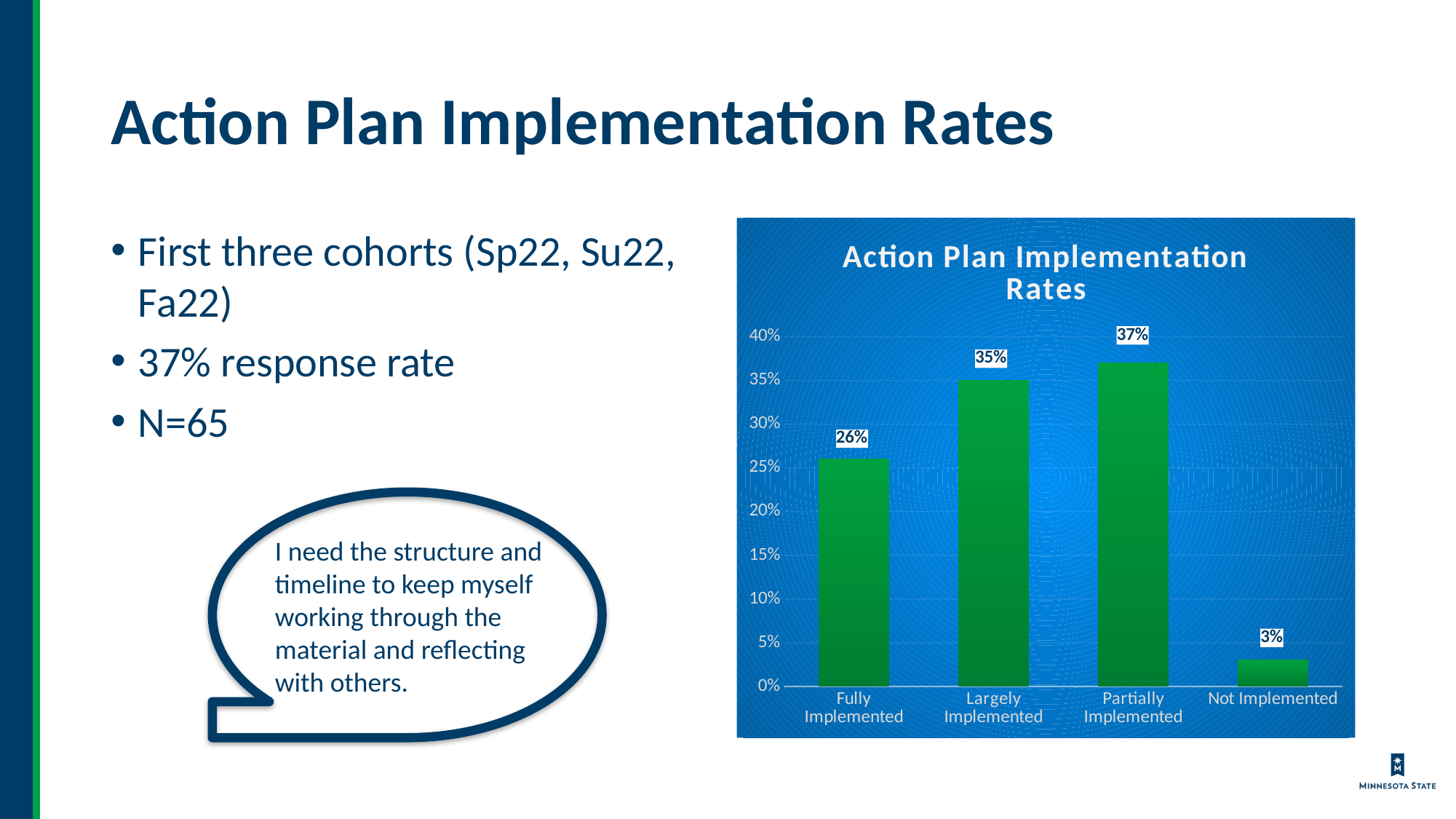
What is the title of the chart? Action Plan Implementation Rates What is the value for Not Implemented? 3% What is the value for Fully Implemented? 26% How many categories are shown on the x axis? 4 What kind of chart is shown on the slide? Bar chart What is the difference between the values for Partially Implemented and Fully Implemented? 11% Which is larger, the value for Fully Implemented or the value for Largely Implemented? Largely Implemented Which category has the lowest value? Not Implemented What is the value for Largely Implemented? 35% What is the value for Partially Implemented? 37% What is the difference between the values for Largely Implemented and Not Implemented? 32% Which category has the highest value? Partially Implemented